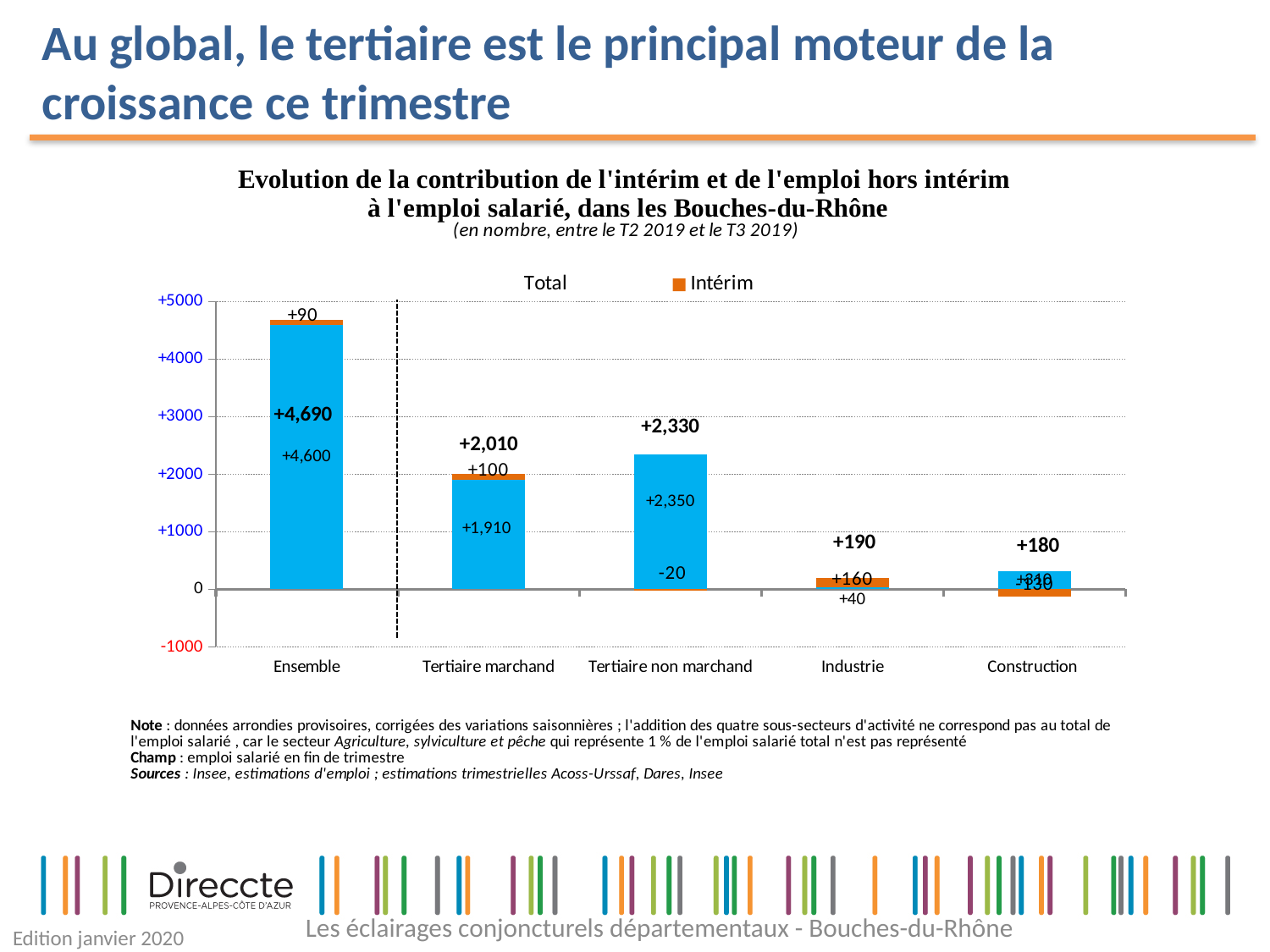
What is the Intérim value for Tertiaire non marchand? -20 Which category has the lowest total value? Construction What kind of chart is shown on the slide? Bar chart What is the total value shown for Industrie? +190 Which is larger, the total for Tertiaire non marchand or the total for Tertiaire marchand? Tertiaire non marchand Which series in the legend is shown in orange? Intérim What is the total value shown for Ensemble? +4,690 Is the blue bar for Tertiaire non marchand greater or less than +2000? greater What is the Intérim value for Tertiaire marchand? +100 Which category has the highest total value? Ensemble What is the difference between the total for Tertiaire non marchand (+2,330) and the total for Tertiaire marchand (+2,010)? 320 How many categories are shown on the x axis? 5